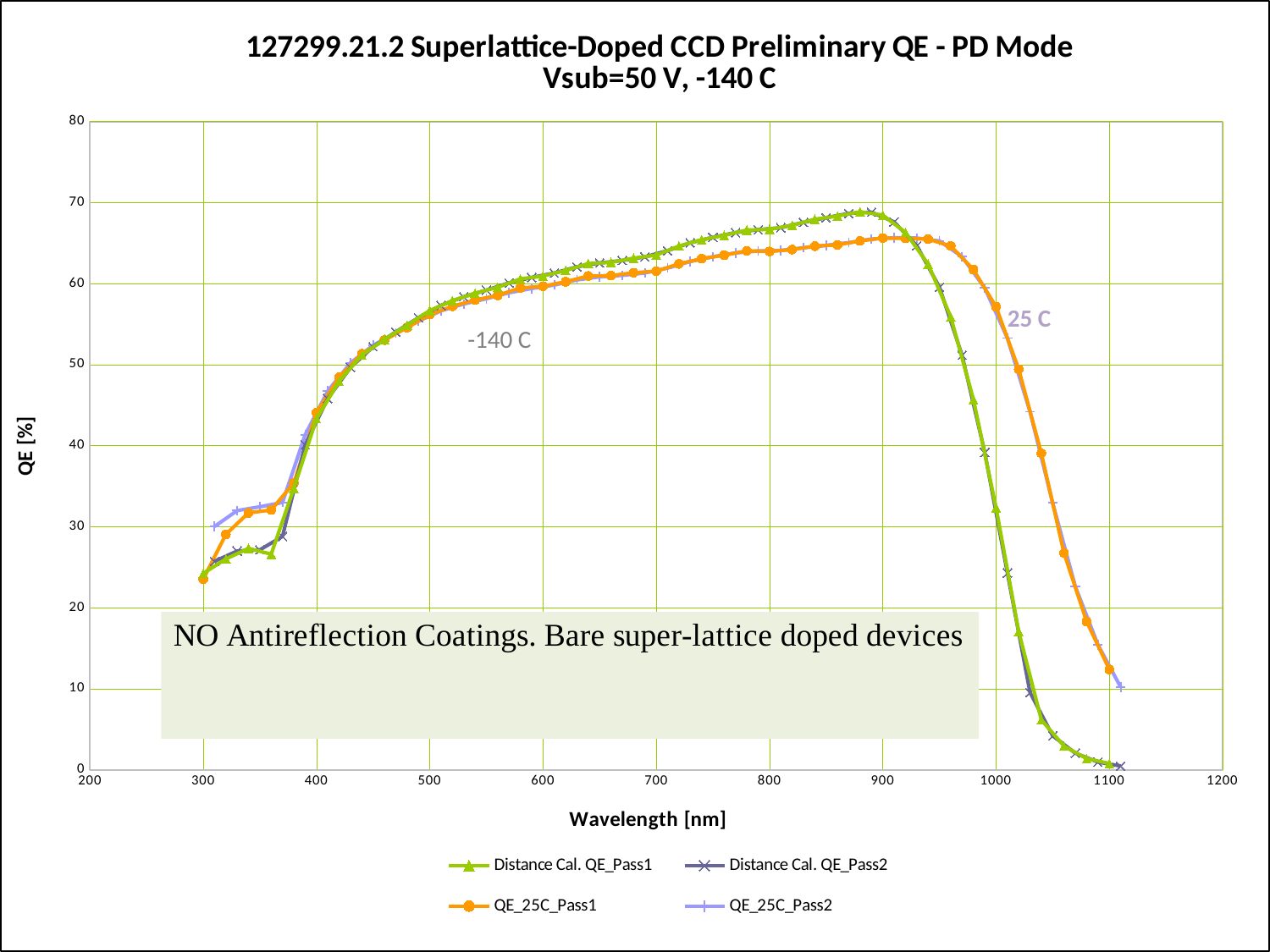
What kind of chart is shown on the slide? Line chart Is the value of Distance Cal. QE_Pass1 at 1000 nm greater or less than 40? less Is the value of Distance Cal. QE_Pass1 at 900 nm greater or less than 60? greater Is the value of QE_25C_Pass1 at 1000 nm greater or less than 50? greater How many series does the legend list? 4 Does the Distance Cal. QE_Pass1 series rise or fall between 400 nm and 900 nm? rise At 1000 nm, which series has the higher QE, QE_25C_Pass1 or Distance Cal. QE_Pass1? QE_25C_Pass1 What is the y-axis label of the chart? QE [%] Which temperature curve reaches the higher peak QE, -140 C or 25 C? -140 C What is the x-axis label of the chart? Wavelength [nm]